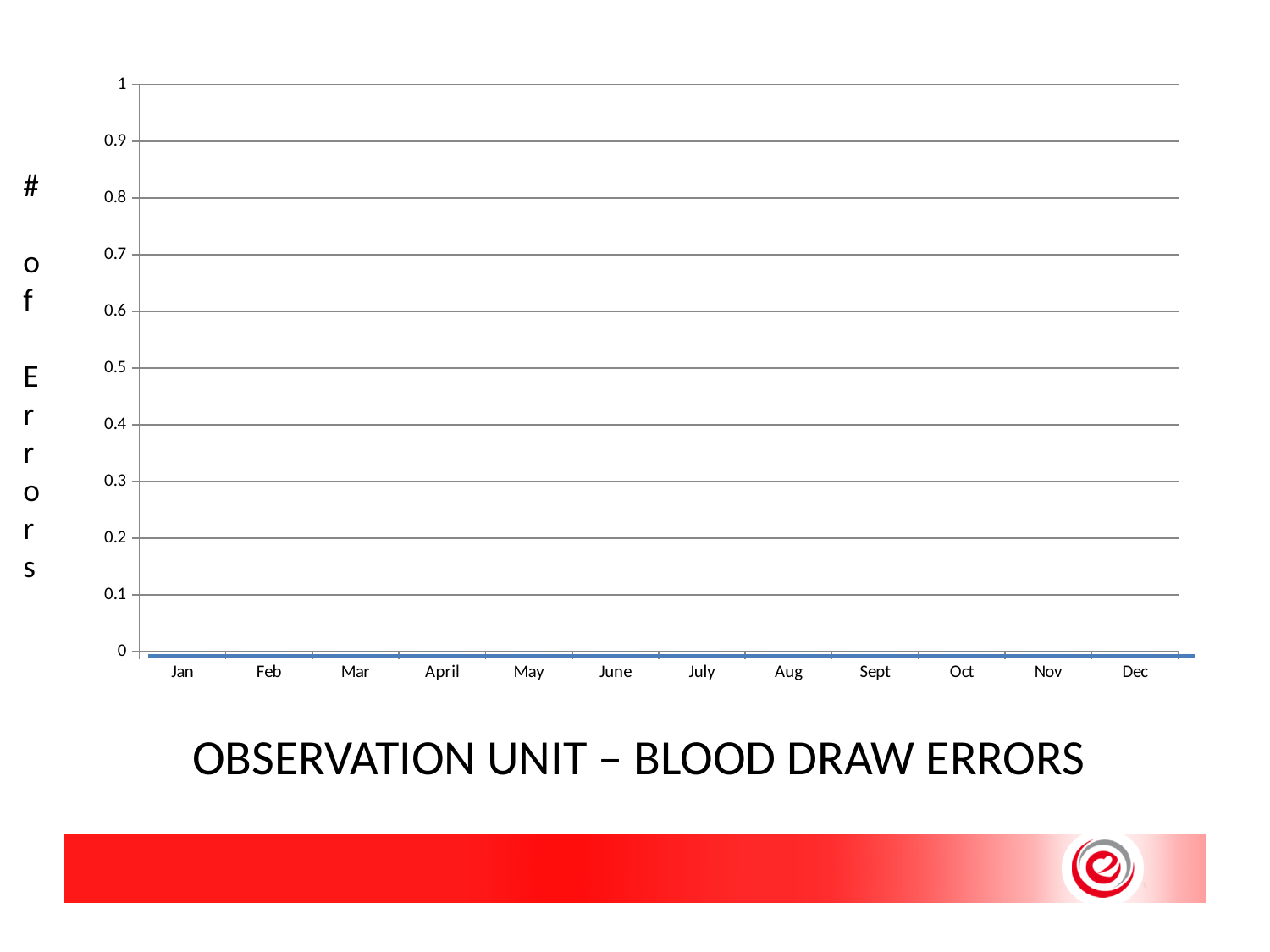
What is the difference between the values for Mar and Sept? 0 What is the number of errors for July? 0 What is the highest value shown on the vertical axis? 1 Is the value for Oct greater or less than 0.1? less How many months are shown along the x axis of the chart? 12 What is the number of errors for Dec? 0 What is the title of the chart? OBSERVATION UNIT – BLOOD DRAW ERRORS Do the values rise, fall, or stay flat from Jan to Dec? stay flat Is the value for May greater or less than 0.5? less What kind of chart is shown on the slide? bar chart What is the label on the vertical axis of the chart? # of Errors What is the number of errors for Jan? 0